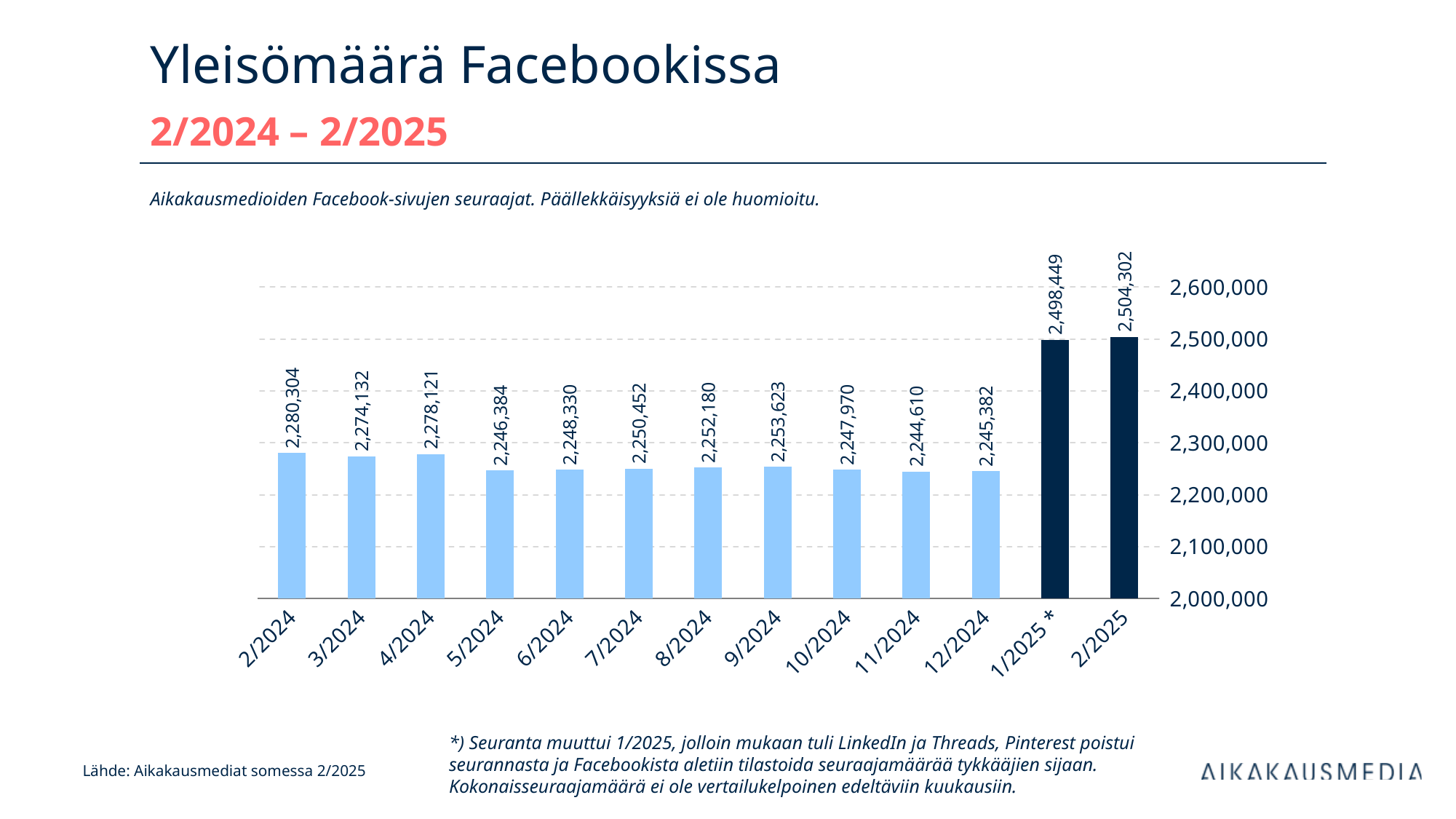
What is the difference between the values for 2/2025 and 1/2025? 5,853 What kind of chart is shown on the slide? bar chart Do the values rise or fall from 5/2024 to 9/2024? rise Which month has the highest value? 2/2025 Which is larger, the value for 2/2024 or the value for 3/2024? 2/2024 How many months are shown on the x axis? 13 Is the value for 1/2025 greater or less than 2,400,000? greater What is the value for 9/2024? 2,253,623 What is the difference between the values for 2/2024 and 12/2024? 34,922 Which month has the lowest value? 11/2024 What is the value for 2/2024? 2,280,304 What is the value for 2/2025? 2,504,302